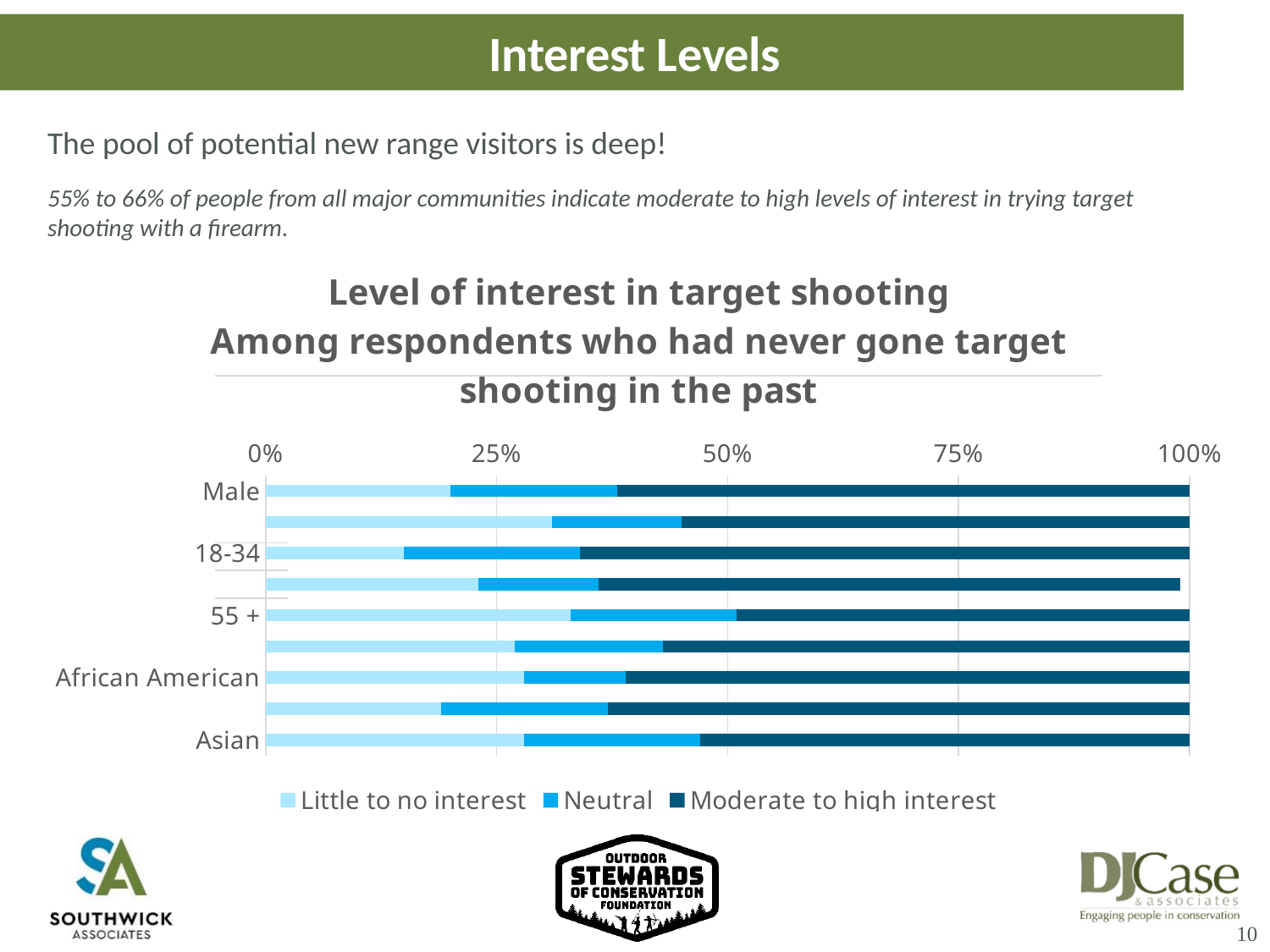
Is the 'Little to no interest' share for Male greater or less than 25%? less How many series does the chart legend list? 3 How many bars are plotted in the chart? 9 Which has the larger 'Little to no interest' share, 18-34 or 55 +? 55 + Is the 'Little to no interest' share for 55 + greater or less than 25%? greater Among the labeled categories Male, 18-34, 55 +, African American and Asian, which has the smallest 'Little to no interest' share? 18-34 Is the 'Little to no interest' share for African American greater or less than 25%? greater What kind of chart is shown on the slide? Stacked horizontal bar chart What is the highest value shown on the chart's percentage axis? 100% What are the three series named in the chart legend? Little to no interest, Neutral, Moderate to high interest